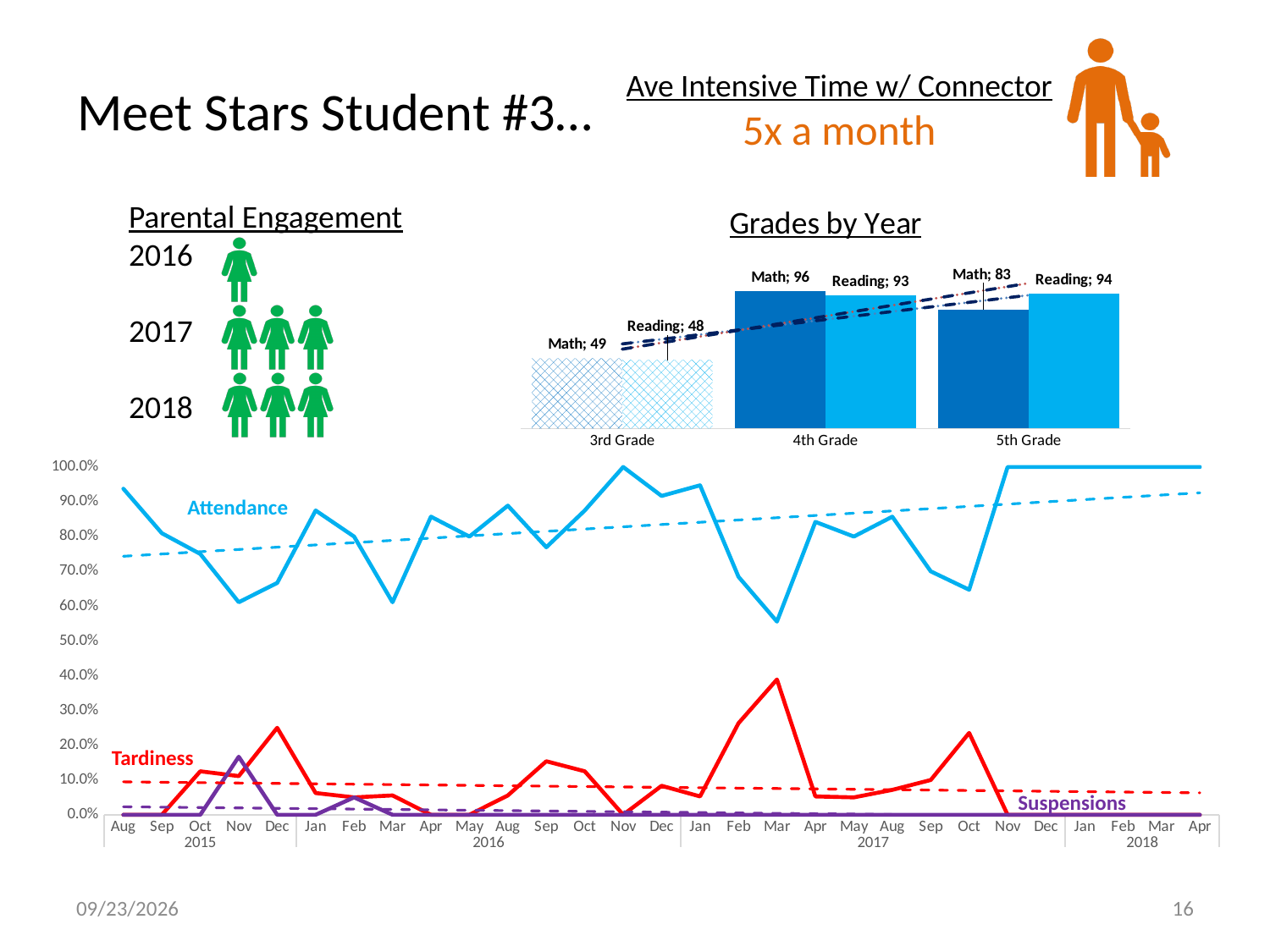
In the line chart at the bottom of the slide, is the Tardiness value for Mar 2017 greater or less than 30.0%? greater In the Grades by Year chart, what is the difference between the Math score in 4th Grade and the Math score in 5th Grade? 13 In the Grades by Year chart, what is the Math score for 4th Grade? 96 In the Grades by Year chart, what is the Reading score for 5th Grade? 94 How many grade levels are shown on the x axis of the Grades by Year chart? 3 In the Grades by Year chart, which grade has the lowest Reading score? 3rd Grade What kind of chart is the Grades by Year chart? bar chart In the Grades by Year chart, which is larger for 5th Grade, the Math score or the Reading score? Reading In the Grades by Year chart, what is the Reading score for 3rd Grade? 48 In the Grades by Year chart, which grade has the highest Math score? 4th Grade In the line chart at the bottom of the slide, does the dashed Attendance trend line rise or fall from Aug 2015 to Apr 2018? rise In the line chart at the bottom of the slide, is the Attendance value for Mar 2017 greater or less than 60.0%? less